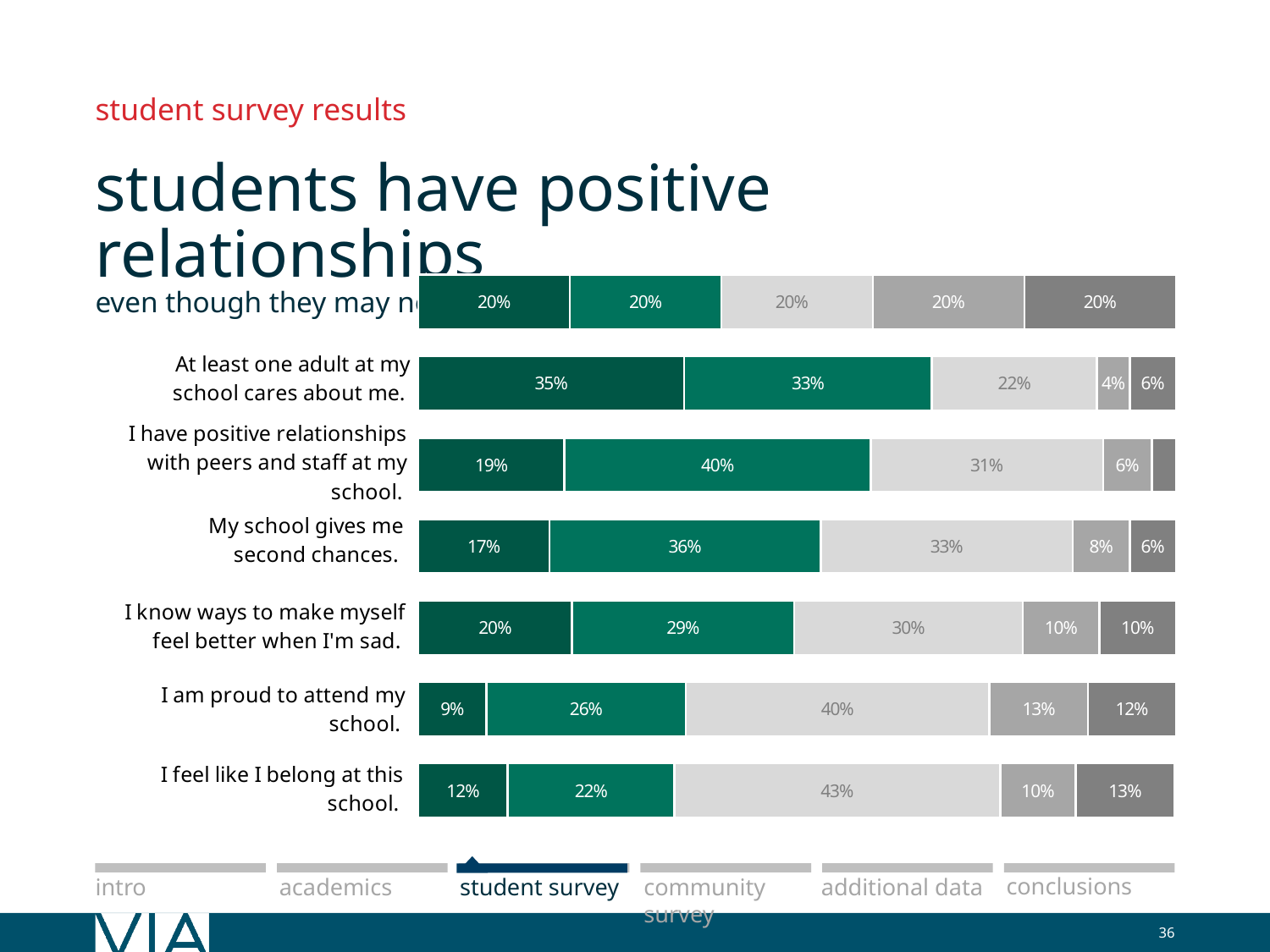
How many survey statements are listed as categories on the chart? 6 What is the difference between the green (second) segment values for "My school gives me second chances." and "I feel like I belong at this school."? 14% How many colored segments make up each bar in the chart? 5 What is the value of the green (second) segment for "I have positive relationships with peers and staff at my school."? 40% Which statement has the highest value in the dark green (first) segment? At least one adult at my school cares about me. What is the value of the dark green (first) segment for "At least one adult at my school cares about me."? 35% Which statement has the lowest value in the dark green (first) segment? I am proud to attend my school. Which statement has the highest value in the light gray (middle) segment? I feel like I belong at this school. What kind of chart is shown on the slide? stacked bar chart What is the value of the light gray (middle) segment for "I feel like I belong at this school."? 43% What is the value of the dark gray (last) segment for "I am proud to attend my school."? 12% Which is larger: the dark green (first) segment for "I know ways to make myself feel better when I'm sad." or for "My school gives me second chances."? I know ways to make myself feel better when I'm sad.